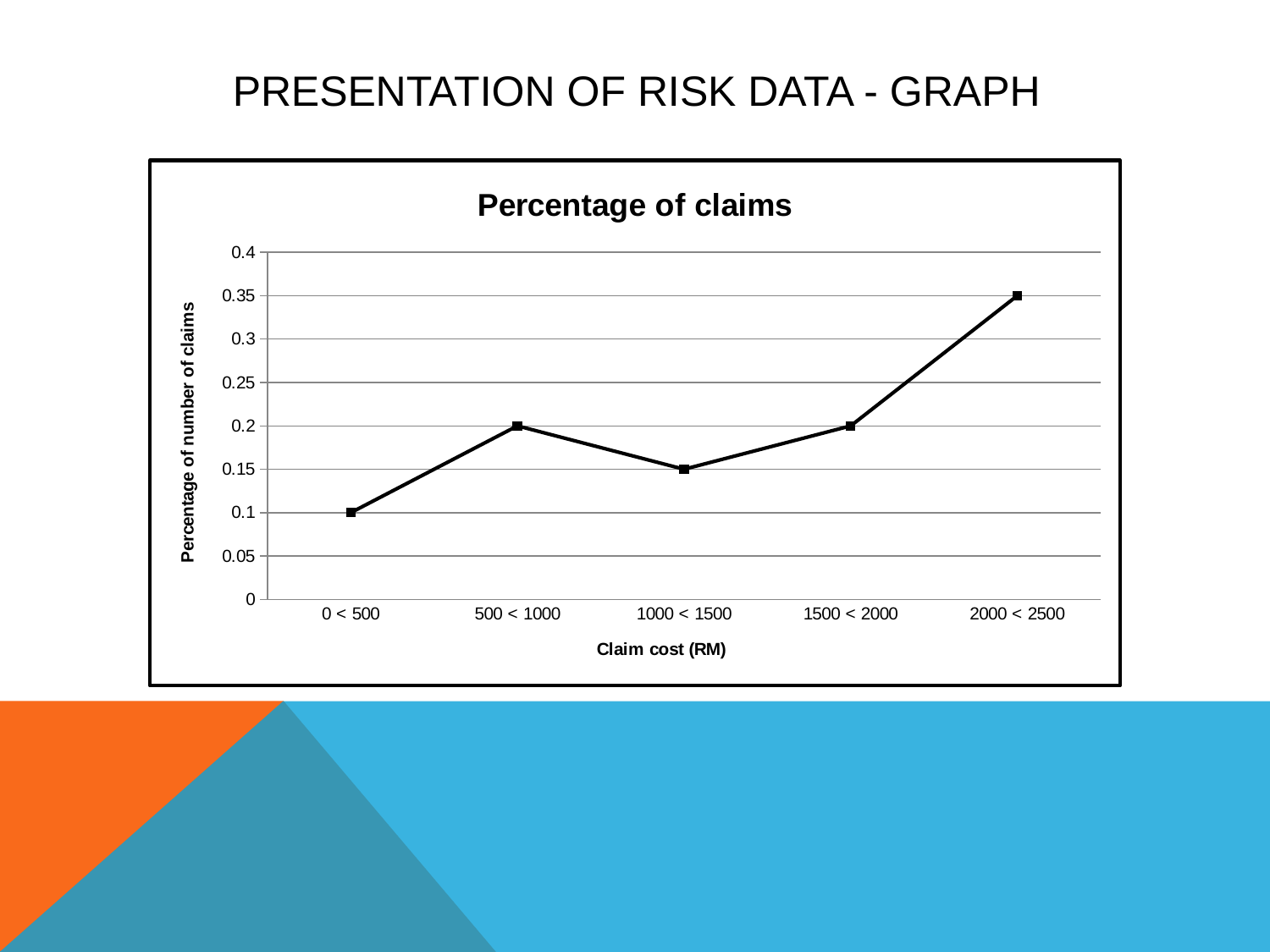
Which claim cost category has the lowest percentage of number of claims? 0 < 500 What is the percentage of number of claims for the 2000 < 2500 claim cost category? 0.35 What is the label of the x axis? Claim cost (RM) How many claim cost categories are plotted on the x axis? 5 What is the percentage of number of claims for the 1000 < 1500 claim cost category? 0.15 Which has a larger percentage of number of claims, 500 < 1000 or 1000 < 1500? 500 < 1000 What type of chart is shown on the slide? Line chart Is the value for 2000 < 2500 greater or less than 0.3? greater What is the difference between the percentage of claims for 2000 < 2500 and for 1500 < 2000? 0.15 What is the percentage of number of claims for the 0 < 500 claim cost category? 0.1 Which claim cost category has the highest percentage of number of claims? 2000 < 2500 What is the title of the chart? Percentage of claims